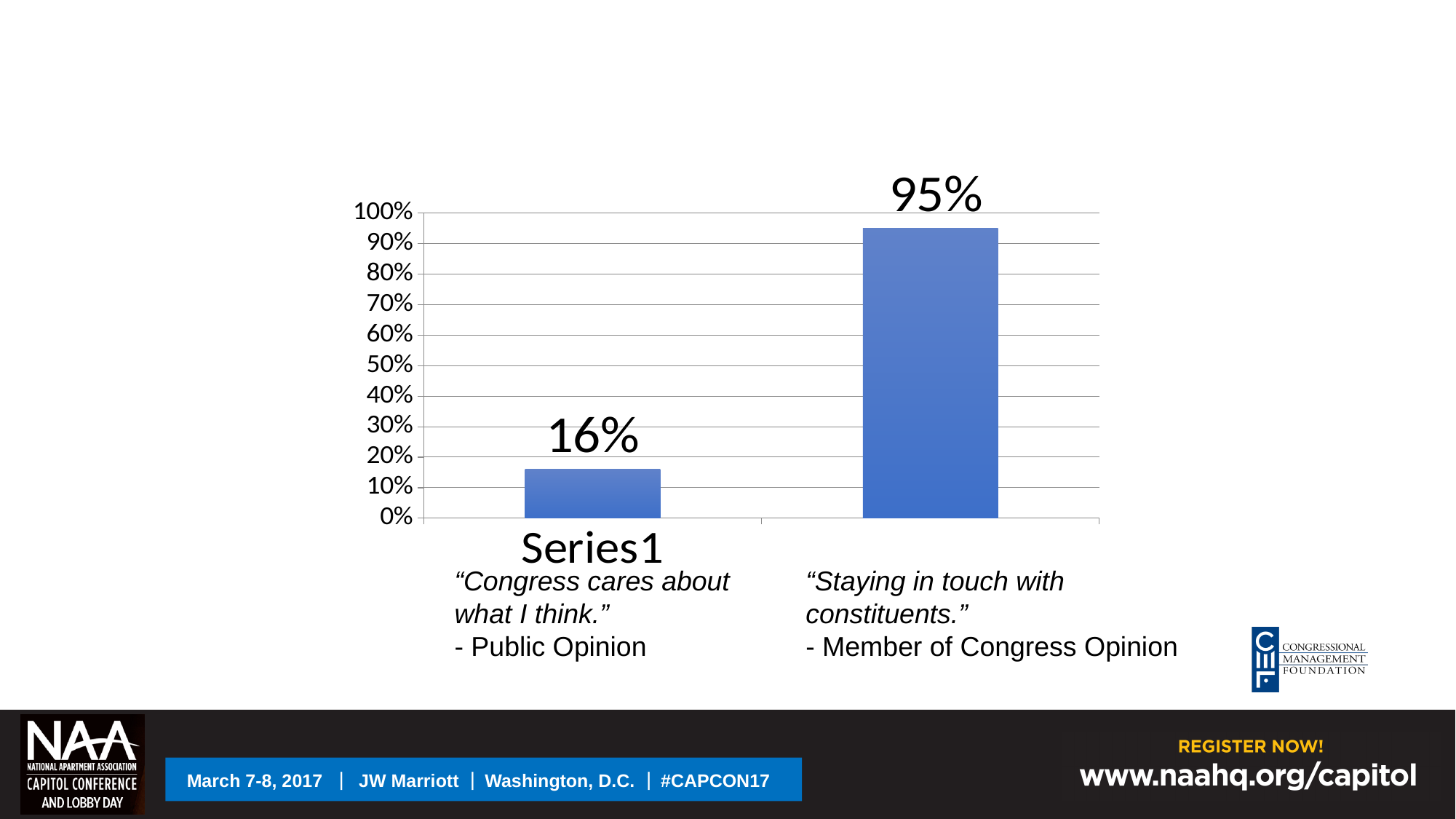
Which bar is the highest: the Public Opinion bar or the Member of Congress Opinion bar? Member of Congress Opinion What value is shown on the left bar, labelled "Congress cares about what I think." (Public Opinion)? 16% What category label is printed on the horizontal axis under the left bar? Series1 What is the difference between the Member of Congress Opinion value (95%) and the Public Opinion value (16%)? 79% How many bars are plotted in the chart? 2 What kind of chart is shown on the slide? bar chart Is the value for the Member of Congress Opinion bar greater or less than 90%? greater Which bar is the lowest: the Public Opinion bar or the Member of Congress Opinion bar? Public Opinion What value is shown on the right bar, labelled "Staying in touch with constituents." (Member of Congress Opinion)? 95% Is the value for the Public Opinion bar greater or less than 20%? less Is the value for the left bar (Public Opinion) larger or smaller than the value for the right bar (Member of Congress Opinion)? smaller What is the highest tick value shown on the vertical axis? 100%